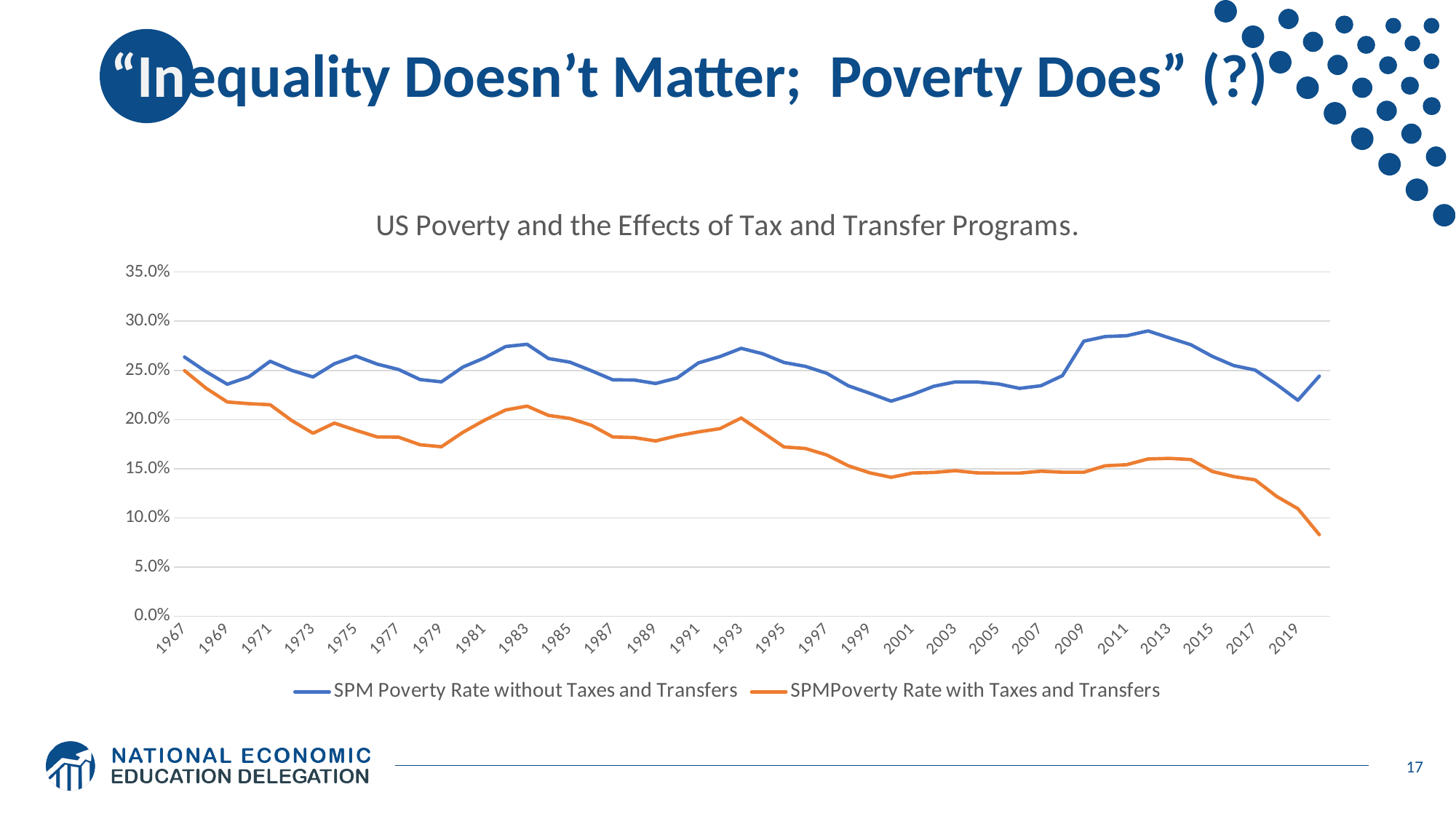
What is the title of the chart? US Poverty and the Effects of Tax and Transfer Programs. Is the value for SPMPoverty Rate with Taxes and Transfers in 1967 greater or less than 20.0%? greater For SPM Poverty Rate without Taxes and Transfers, which year has the higher value: 1983 or 1999? 1983 How many series does the chart's legend list? 2 What kind of chart is shown on the slide? line chart For SPMPoverty Rate with Taxes and Transfers, which year has the higher value: 1967 or 2017? 1967 Which series is drawn in orange? SPMPoverty Rate with Taxes and Transfers Overall, does the SPMPoverty Rate with Taxes and Transfers line rise or fall from 1967 to 2019? fall In 2019, which series has the higher value: SPM Poverty Rate without Taxes and Transfers or SPMPoverty Rate with Taxes and Transfers? SPM Poverty Rate without Taxes and Transfers Is the value for SPMPoverty Rate with Taxes and Transfers in 2009 greater or less than 20.0%? less Is the value for SPM Poverty Rate without Taxes and Transfers in 2013 greater or less than 25.0%? greater